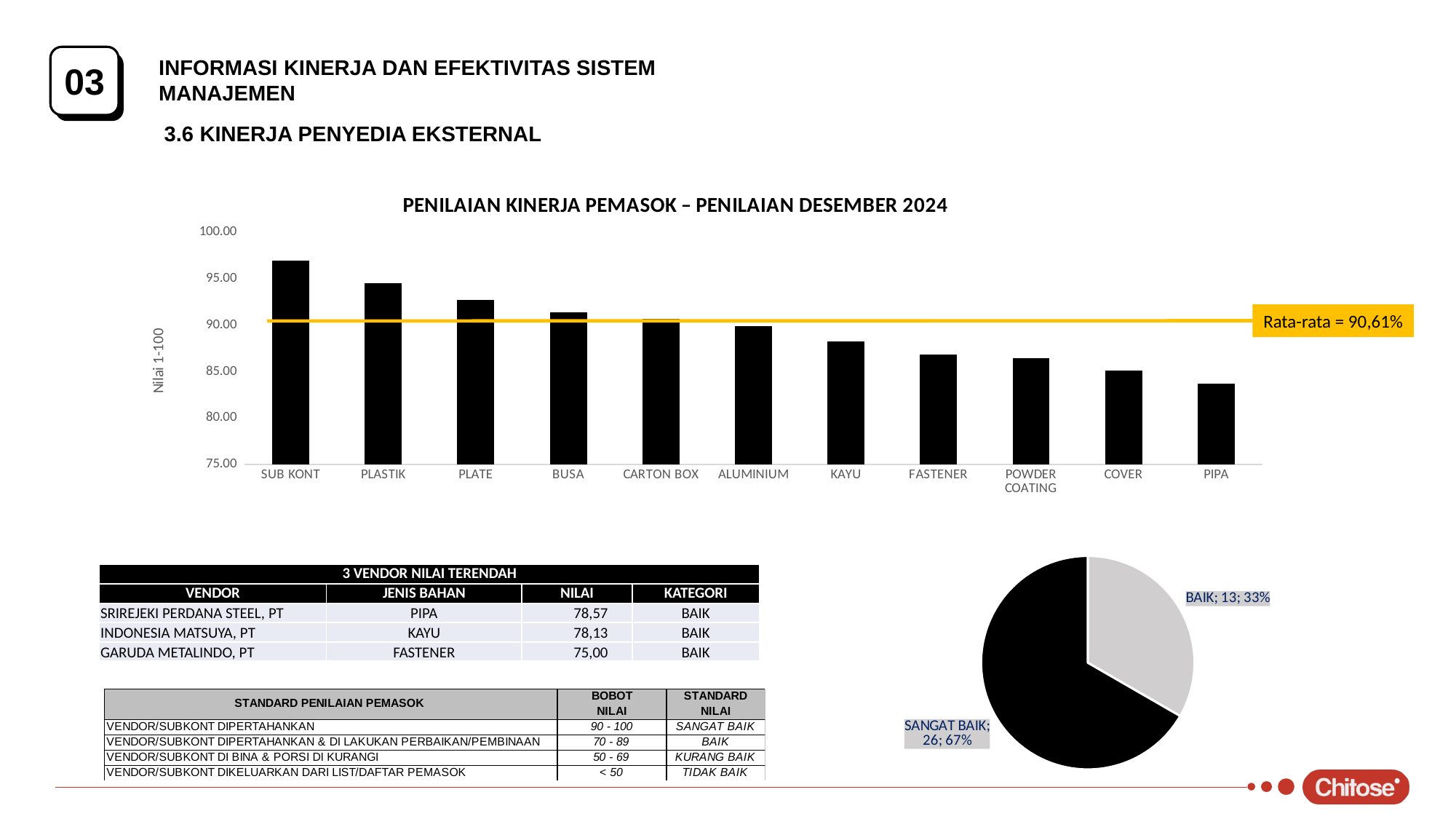
In the bar chart 'PENILAIAN KINERJA PEMASOK – PENILAIAN DESEMBER 2024', do the values rise or fall from left to right along the x axis? fall In the bar chart 'PENILAIAN KINERJA PEMASOK – PENILAIAN DESEMBER 2024', is the value for SUB KONT greater or less than 95.00? greater In the bar chart 'PENILAIAN KINERJA PEMASOK – PENILAIAN DESEMBER 2024', what average value (Rata-rata) is marked by the horizontal line? 90,61% In the bar chart 'PENILAIAN KINERJA PEMASOK – PENILAIAN DESEMBER 2024', is the value for PLATE greater or less than 90.00? greater In the bar chart 'PENILAIAN KINERJA PEMASOK – PENILAIAN DESEMBER 2024', is the value for PIPA greater or less than 85.00? less In the bar chart 'PENILAIAN KINERJA PEMASOK – PENILAIAN DESEMBER 2024', which category has the highest value? SUB KONT In the bar chart 'PENILAIAN KINERJA PEMASOK – PENILAIAN DESEMBER 2024', which is larger, the value for PLASTIK or the value for FASTENER? PLASTIK In the pie chart at the bottom right of the slide, what is the value for SANGAT BAIK? 26 In the pie chart at the bottom right of the slide, what share of the pie does the BAIK slice represent? 33% In the bar chart 'PENILAIAN KINERJA PEMASOK – PENILAIAN DESEMBER 2024', how many categories are shown on the x axis? 11 In the bar chart 'PENILAIAN KINERJA PEMASOK – PENILAIAN DESEMBER 2024', which category has the lowest value? PIPA